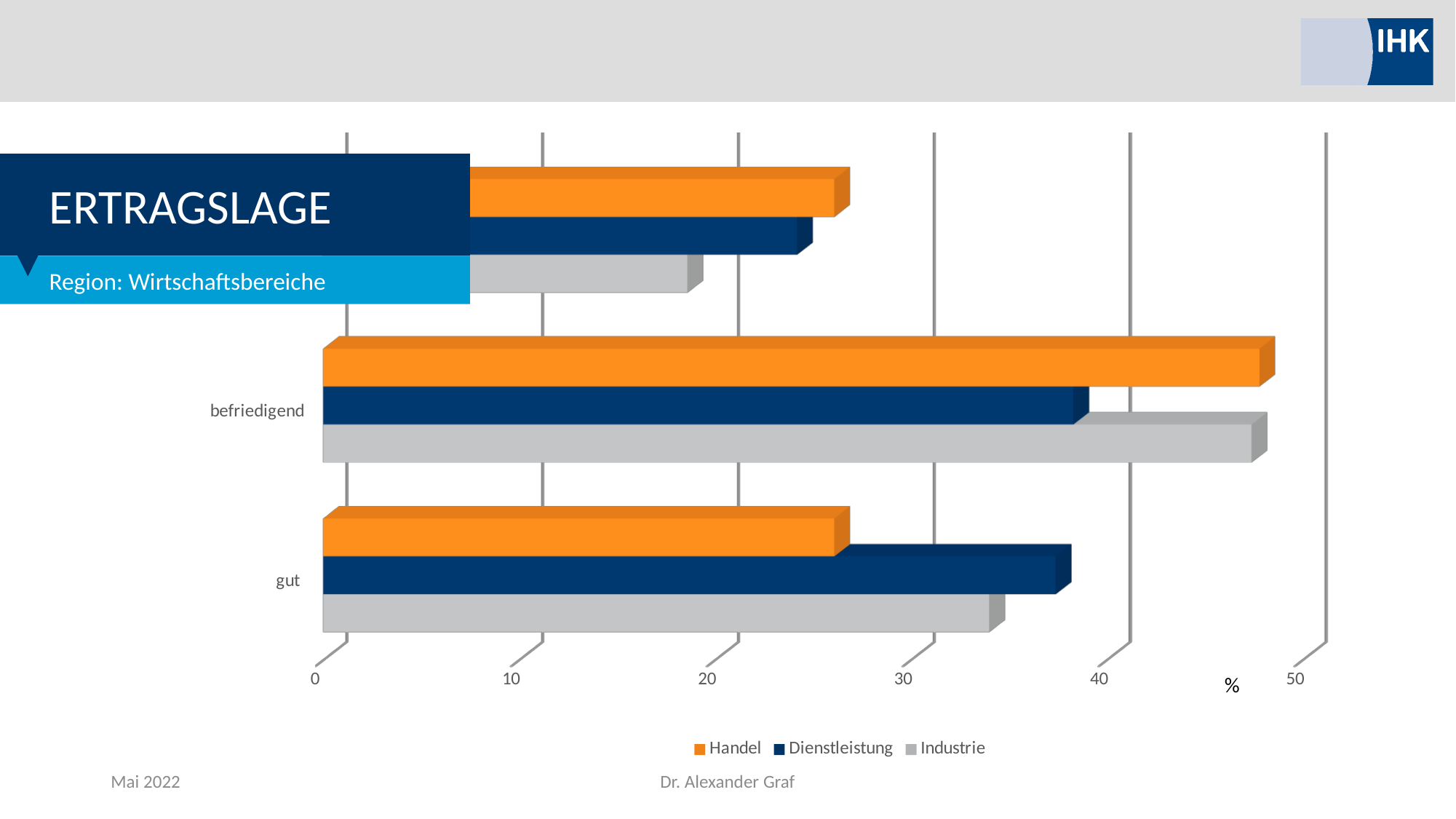
In the 'gut' category, which series has the highest value? Dienstleistung In the 'gut' category, which series has the lowest value? Handel In the 'befriedigend' category, which is larger: the value for Handel or the value for Dienstleistung? Handel Is the value for Handel in the 'befriedigend' category greater or less than 40? greater Which series is shown in orange in the legend? Handel Is the value for Handel in the 'gut' category greater or less than 30? less What is the title shown in the dark blue box on the slide? ERTRAGSLAGE Is the value for Dienstleistung in the 'gut' category greater or less than 30? greater How many series does the legend list? 3 What kind of chart is shown on the slide? bar chart